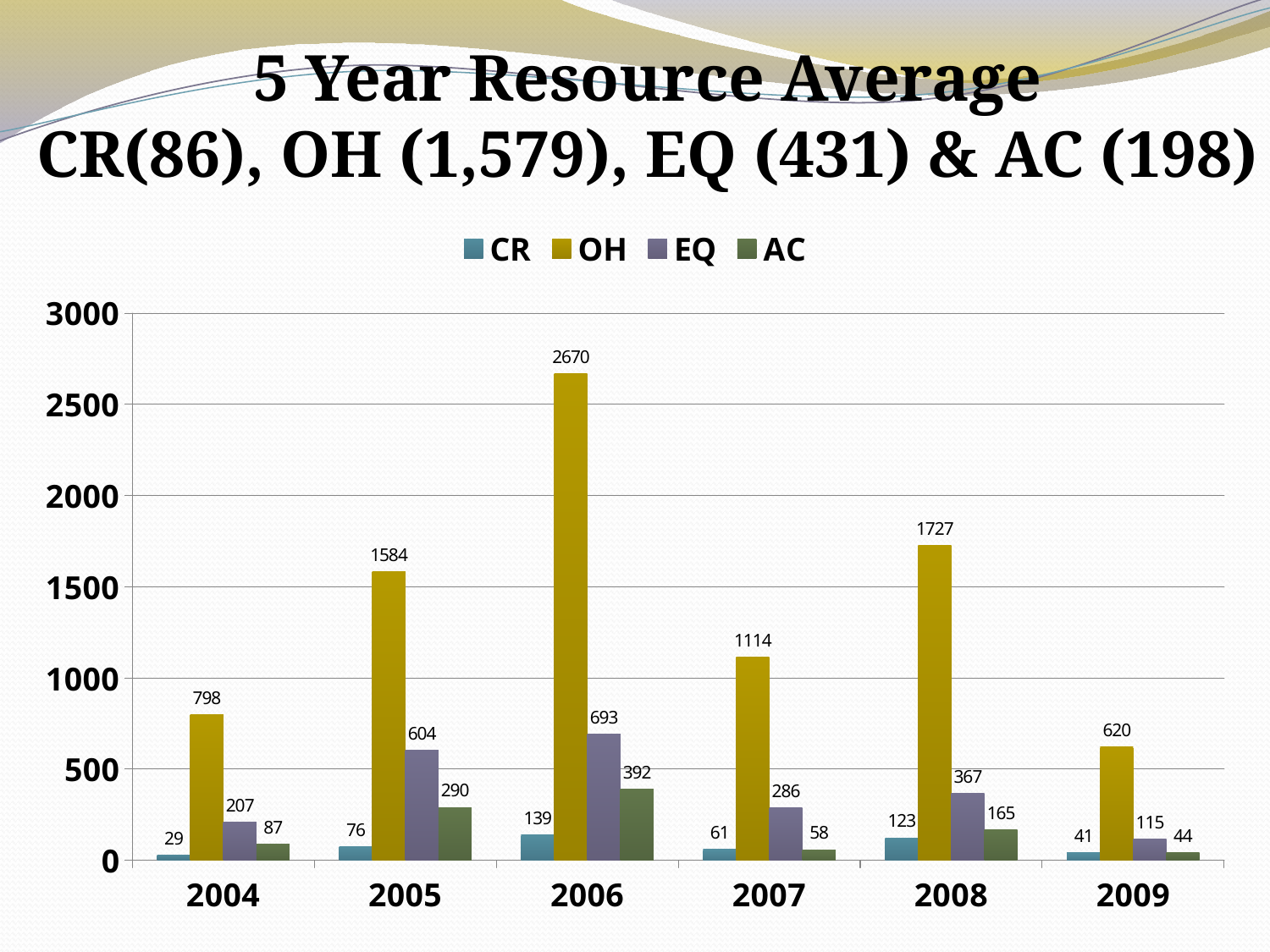
How many years are shown on the x axis? 6 In which year is the CR value lowest? 2004 Which is larger, the EQ value for 2006 or the EQ value for 2009? EQ value for 2006 What is the difference between the OH values for 2008 and 2007? 613 In which year is the OH value highest? 2006 What is the AC value for 2007? 58 Which series is shown in gold/yellow in the legend? OH How many series does the legend list? 4 What is the CR value for 2008? 123 What is the EQ value for 2005? 604 What kind of chart is shown on the slide? Bar chart What is the OH value for 2006? 2670